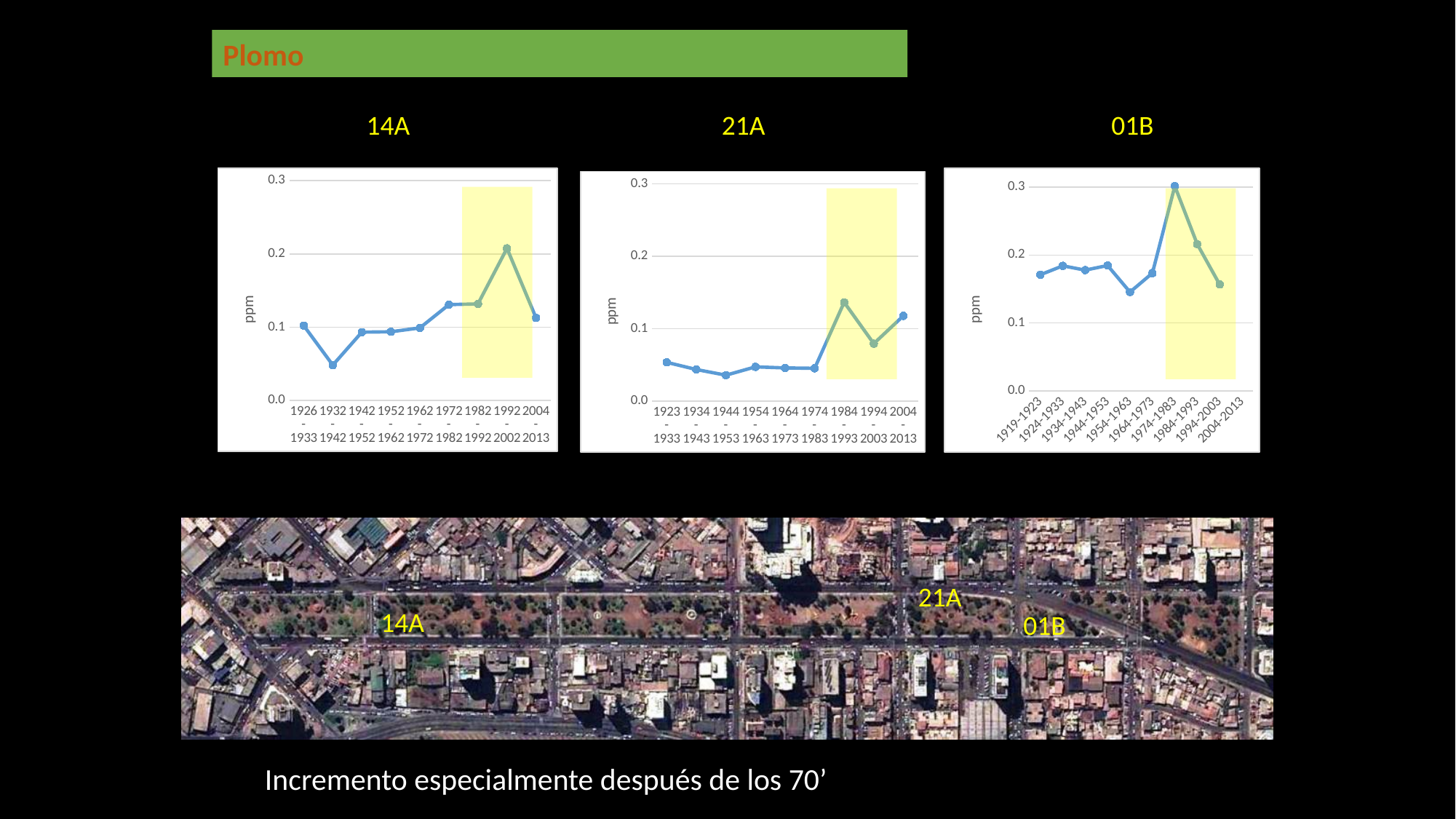
On the 21A chart, which period has the highest value? 1984-1993 What is the y-axis label on the 01B chart? ppm On the 14A chart, which period has the lowest value? 1932-1942 What kind of chart is the 14A chart? line chart On the 21A chart, is the value for 1923-1933 greater or less than 0.1? less How many data points are plotted on the 21A chart? 9 On the 01B chart, which period has the highest value? 1974-1983 On the 14A chart, which period has the highest value? 1992-2002 On the 14A chart, is the value for 1992-2002 greater or less than 0.2? greater On the 21A chart, which is larger, the value for 1984-1993 or the value for 1994-2003? 1984-1993 On the 01B chart, is the value for 1984-1993 greater or less than 0.2? greater On the 01B chart, which period has the lowest value? 1954-1963